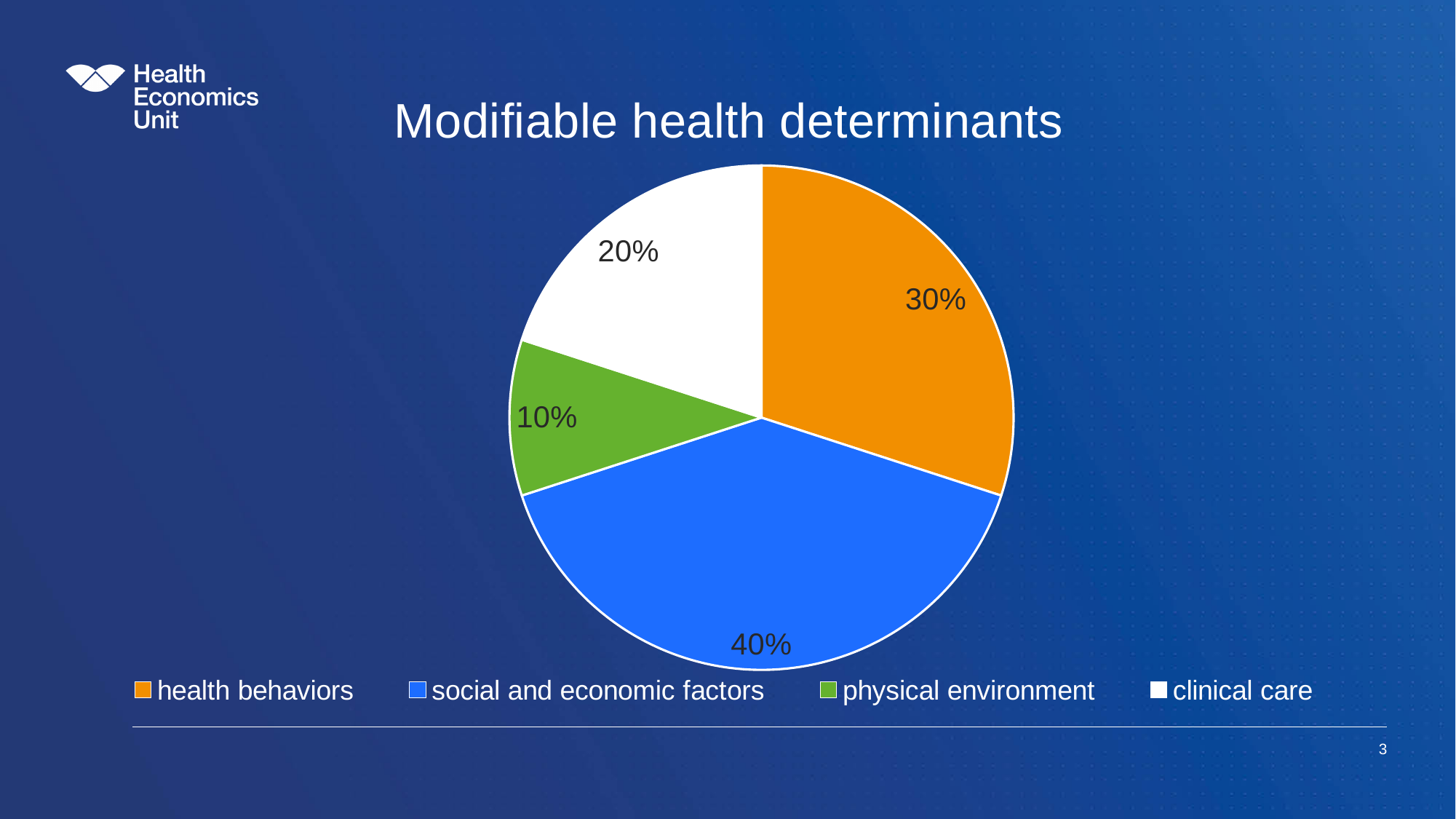
What share of the pie is social and economic factors? 40% What kind of chart is shown on the slide? pie chart What is the difference between the shares for social and economic factors and health behaviors? 10% Which category has the smallest slice of the pie? physical environment Which is larger, the share for clinical care or the share for physical environment? clinical care How many categories does the pie chart show? 4 What is the title of the chart? Modifiable health determinants What share of the pie is health behaviors? 30% What share of the pie is physical environment? 10% Which colour represents physical environment in the legend? green Which category has the largest slice of the pie? social and economic factors What share of the pie is clinical care? 20%